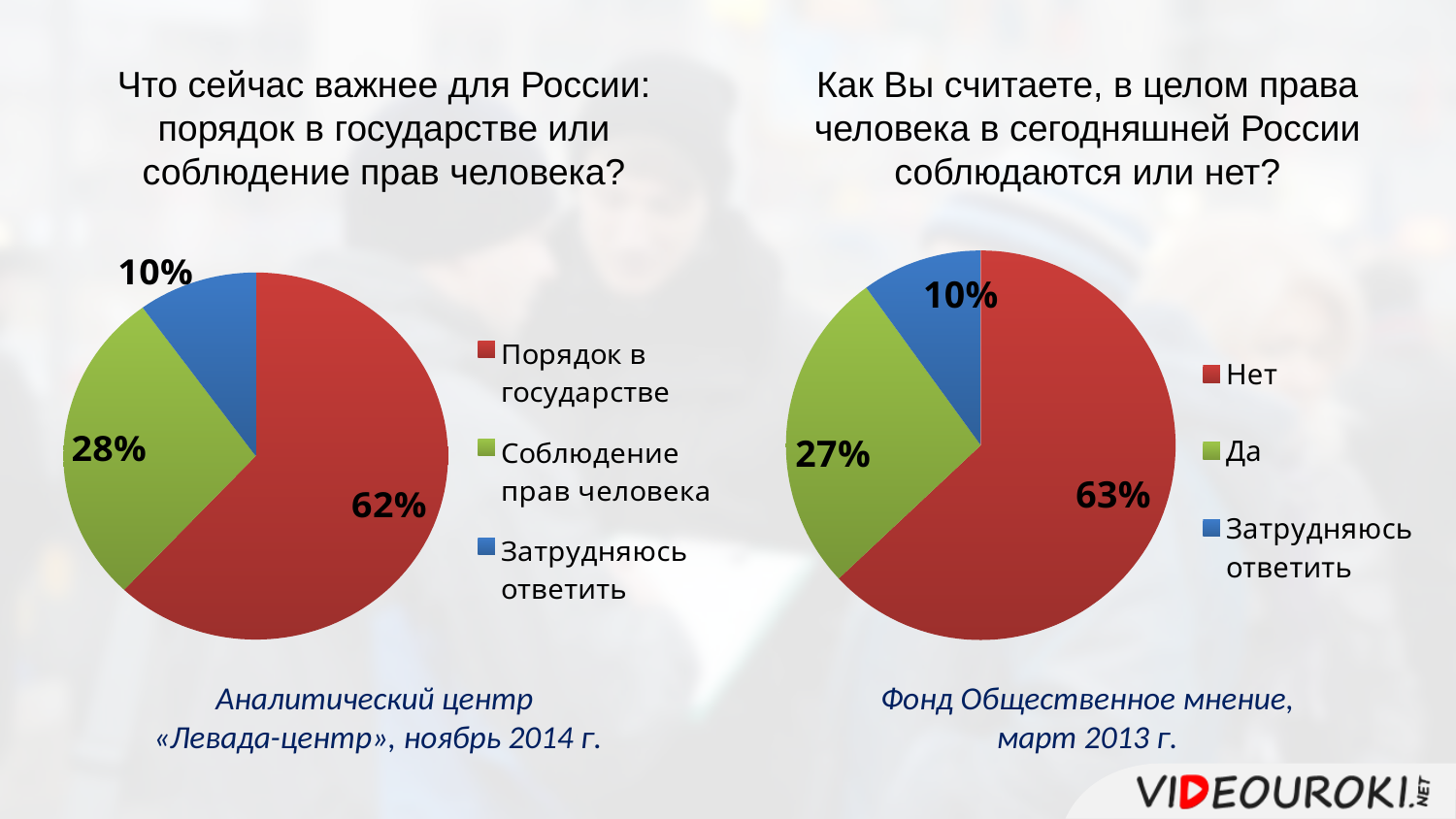
In the right pie chart, which category has the smallest share? Затрудняюсь ответить What type of chart is used on the right side of the slide? Pie chart In the left pie chart, what is the difference in percentage points between "Порядок в государстве" and "Соблюдение прав человека"? 34 In the right pie chart, what share of respondents answered "Да"? 27% What colour represents "Затрудняюсь ответить" in the right pie chart? Blue How many categories does the legend of the left pie chart list? 3 In the left pie chart, which category has the largest share? Порядок в государстве In the right pie chart, what share of respondents answered "Затрудняюсь ответить"? 10% In the left pie chart, what share of respondents chose "Соблюдение прав человека"? 28% In the left pie chart, what share of respondents chose "Порядок в государстве"? 62% In the right pie chart, what share of respondents answered "Нет"? 63% In the right pie chart, which is larger: the share for "Нет" or the share for "Да"? Нет